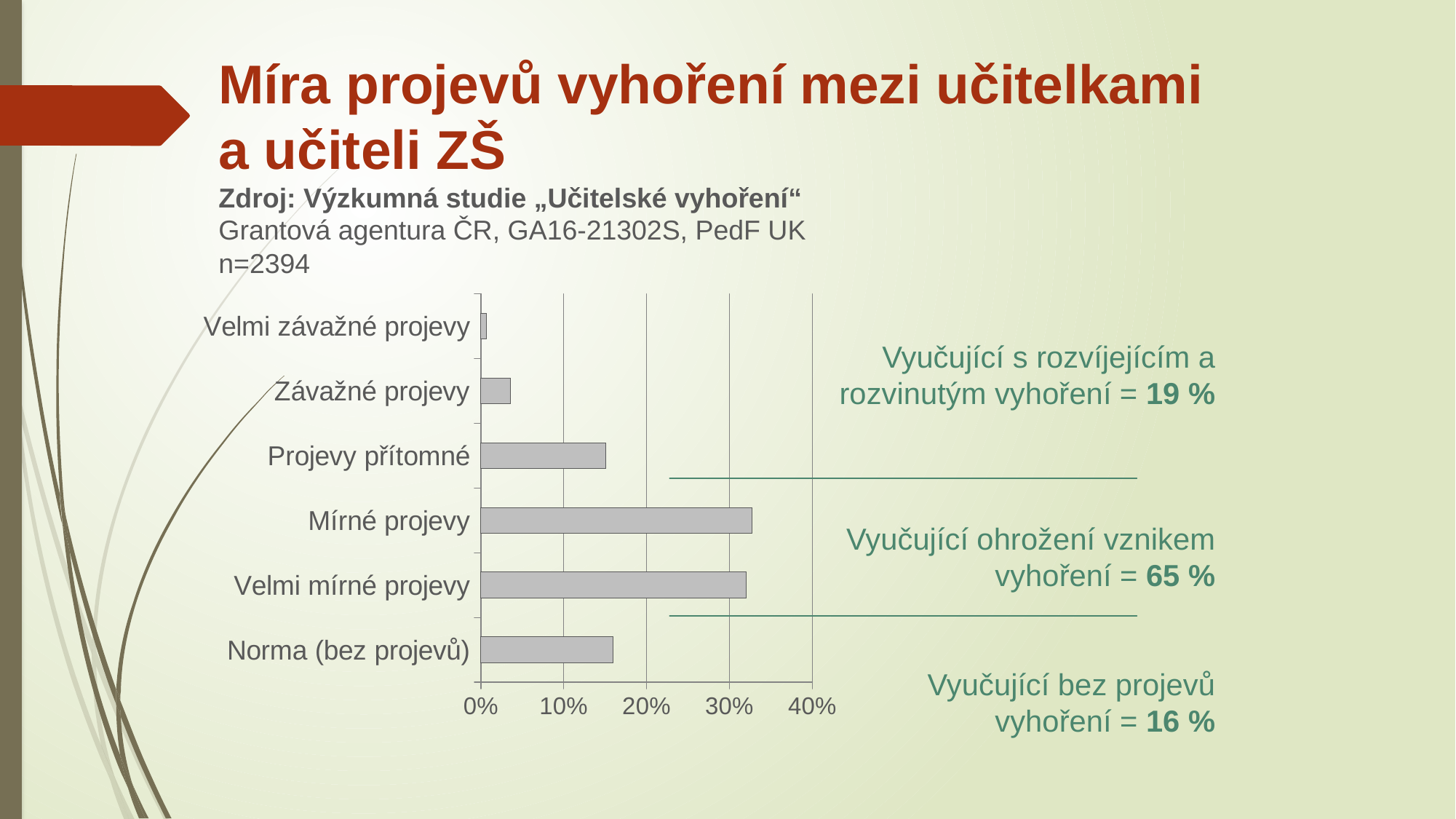
Is the value for Projevy přítomné greater or less than 10%? greater According to the annotation next to the chart, what percentage of teachers are at risk of developing burnout (Vyučující ohrožení vznikem vyhoření)? 65 % Is the value for Velmi mírné projevy greater or less than 30%? greater How many categories does the chart show? 6 What kind of chart is shown on the slide? bar chart Which is larger, the value for Mírné projevy or the value for Projevy přítomné? Mírné projevy Is the value for Norma (bez projevů) greater or less than 20%? less Which is larger, the value for Norma (bez projevů) or the value for Závažné projevy? Norma (bez projevů) Which category has the lowest value in the chart? Velmi závažné projevy What is the highest value shown on the chart's horizontal axis? 40%